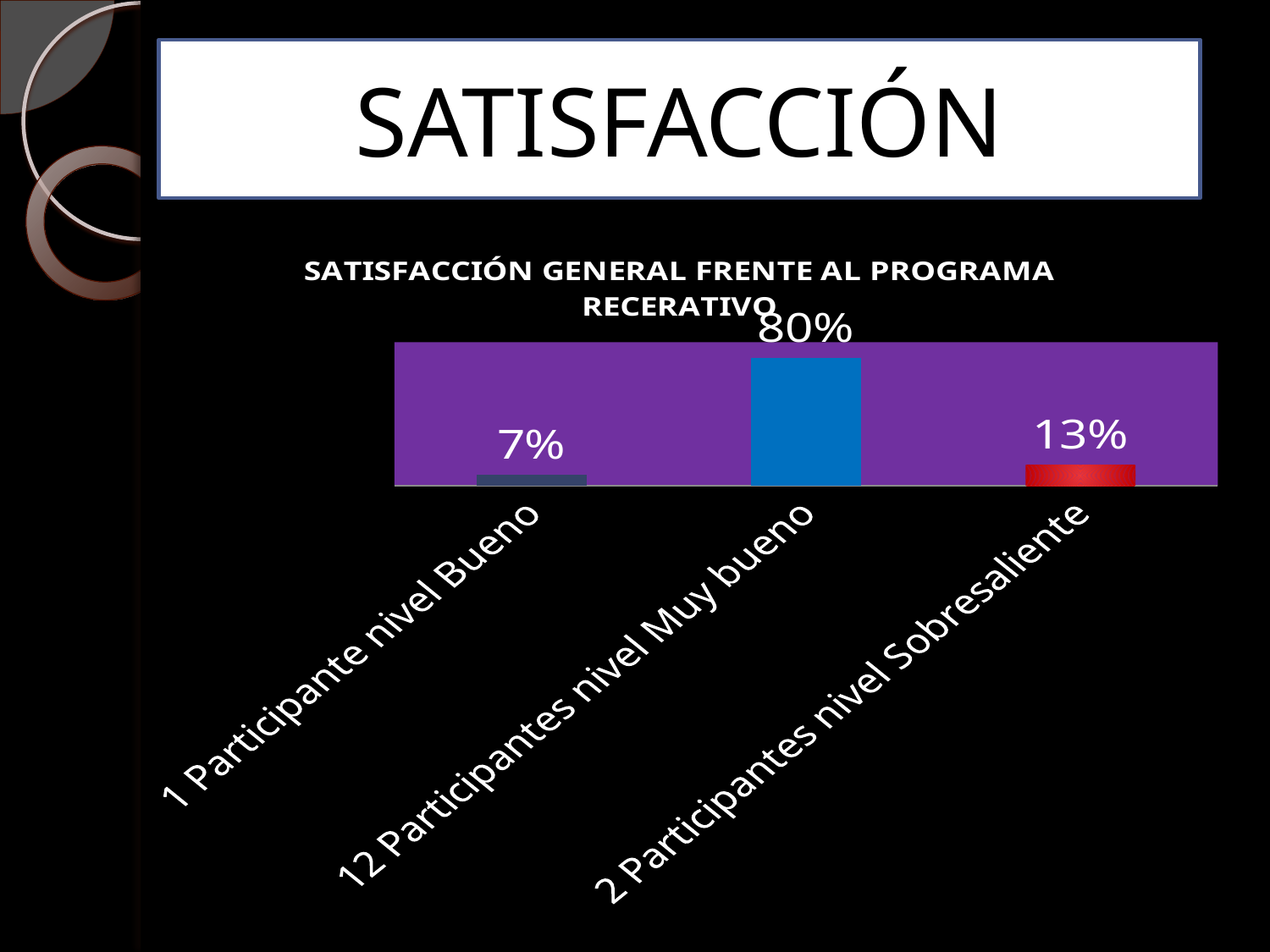
What is the title of the chart? SATISFACCIÓN GENERAL FRENTE AL PROGRAMA RECERATIVO What is the value for '1 Participante nivel Bueno'? 7% What kind of chart is shown on the slide? Bar chart Which category has the lowest value? 1 Participante nivel Bueno Which category has the highest value? 12 Participantes nivel Muy bueno How many categories are shown in the chart? 3 What is the difference between the values for '12 Participantes nivel Muy bueno' and '2 Participantes nivel Sobresaliente'? 67% What is the difference between the values for '2 Participantes nivel Sobresaliente' and '1 Participante nivel Bueno'? 6% What is the value for '12 Participantes nivel Muy bueno'? 80% What is the value for '2 Participantes nivel Sobresaliente'? 13% What colour is the bar for '2 Participantes nivel Sobresaliente'? Red Which is larger, the value for '2 Participantes nivel Sobresaliente' or the value for '1 Participante nivel Bueno'? 2 Participantes nivel Sobresaliente